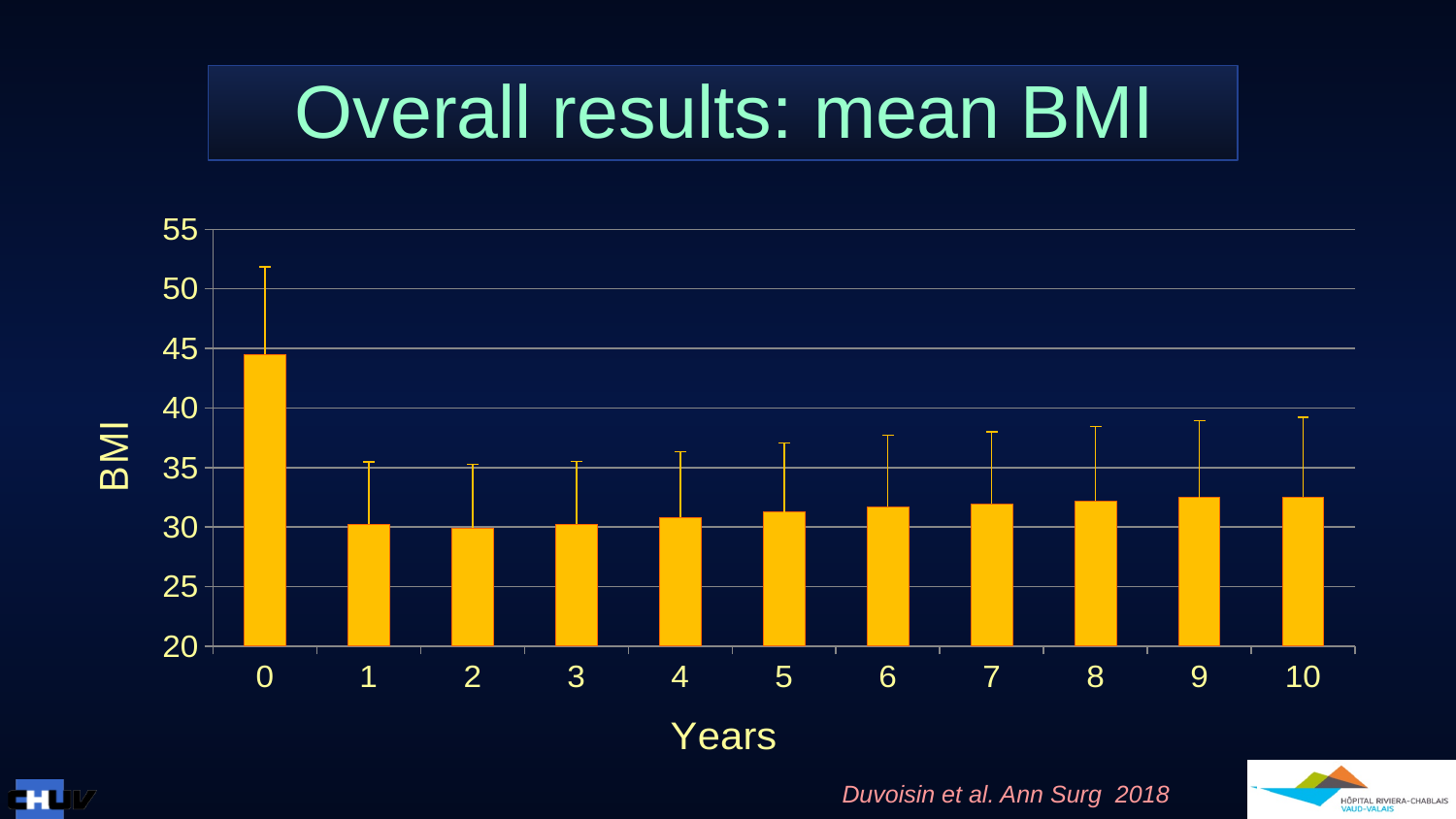
Which is larger, the mean BMI at year 0 or at year 1? year 0 How many bars (years) are plotted in the chart? 11 Is the mean BMI at year 0 greater or less than 50? less Is the mean BMI at year 0 greater or less than 40? greater Is the mean BMI at year 10 greater or less than 30? greater Which year has the highest mean BMI? 0 From year 1 to year 10, does the mean BMI rise or fall? rise What is the label of the x axis? Years What is the title of the chart? Overall results: mean BMI What kind of chart is shown on the slide? bar chart